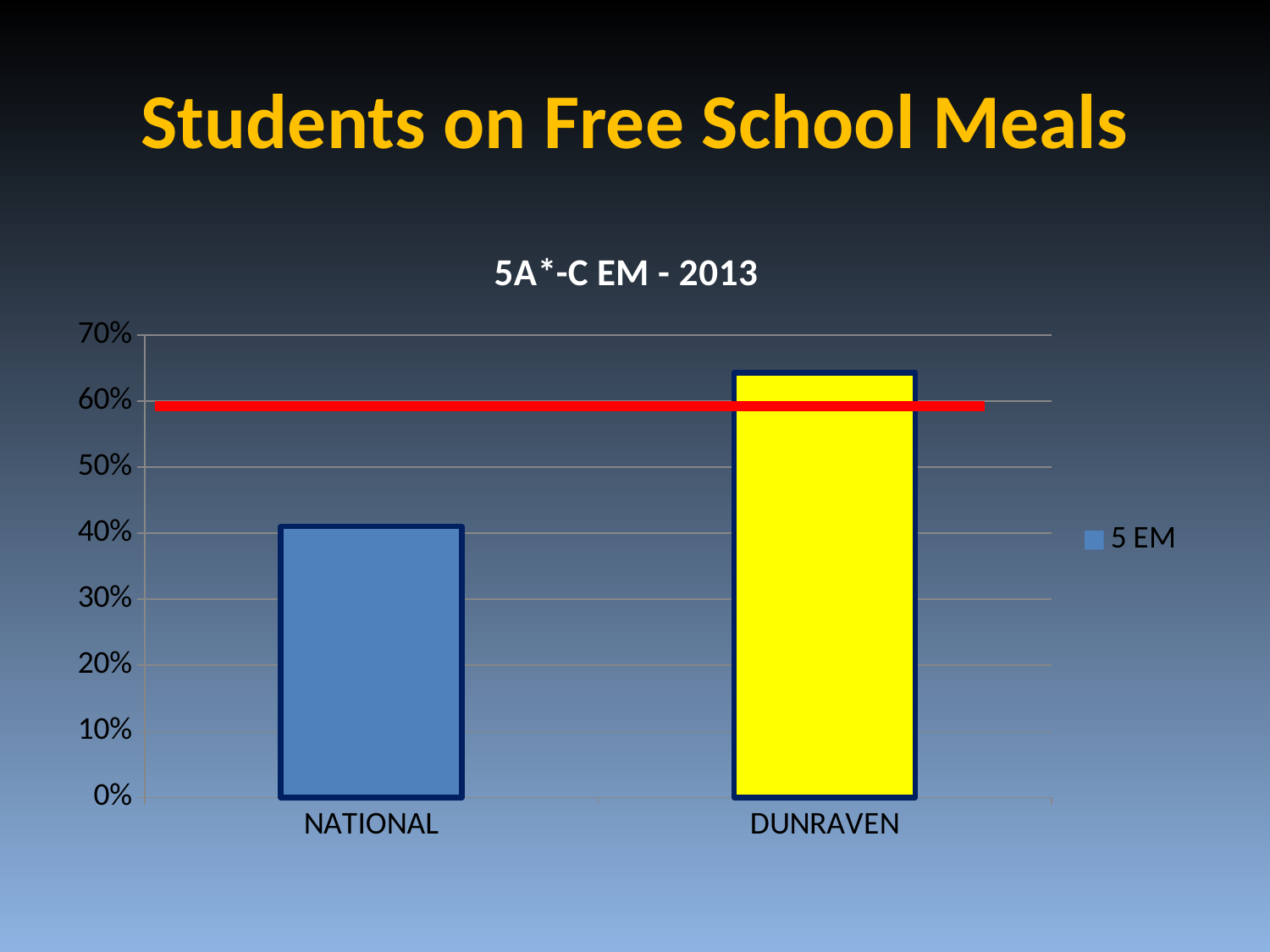
Which is larger, the value for NATIONAL or the value for DUNRAVEN? DUNRAVEN How many categories are plotted on the chart? 2 Which category has the highest value? DUNRAVEN What is the legend entry for the series? 5 EM What kind of chart is shown on the slide? bar chart Is the value for NATIONAL greater or less than 30%? greater How many series does the legend list? 1 Is the value for DUNRAVEN greater or less than 60%? greater Is the value for NATIONAL greater or less than 50%? less What is the title of the chart? 5A*-C EM - 2013 Which category has the lowest value? NATIONAL